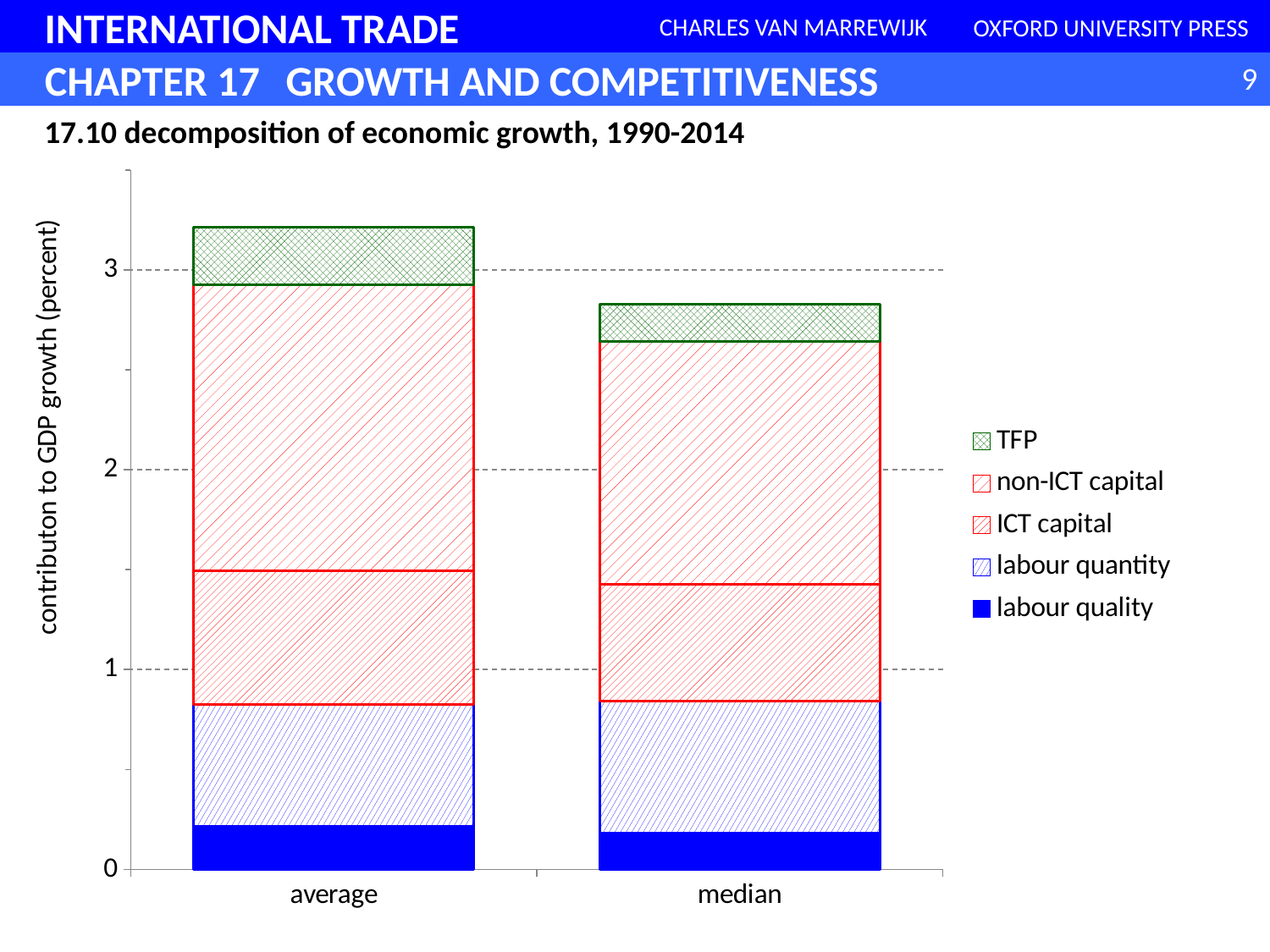
What is the title of the chart? 17.10 decomposition of economic growth, 1990-2014 What kind of chart is shown on the slide? bar chart Is the labour quality contribution for average greater or less than 1? less How many categories are shown on the x axis of the chart? 2 Is the total height of the stacked bar for average greater or less than 3? greater Is the total height of the stacked bar for median greater or less than 3? less Which category has the shorter stacked bar? median How many series does the legend of the chart list? 5 Which series is shown at the top of each stacked bar according to the legend? TFP Which category has the taller stacked bar, average or median? average